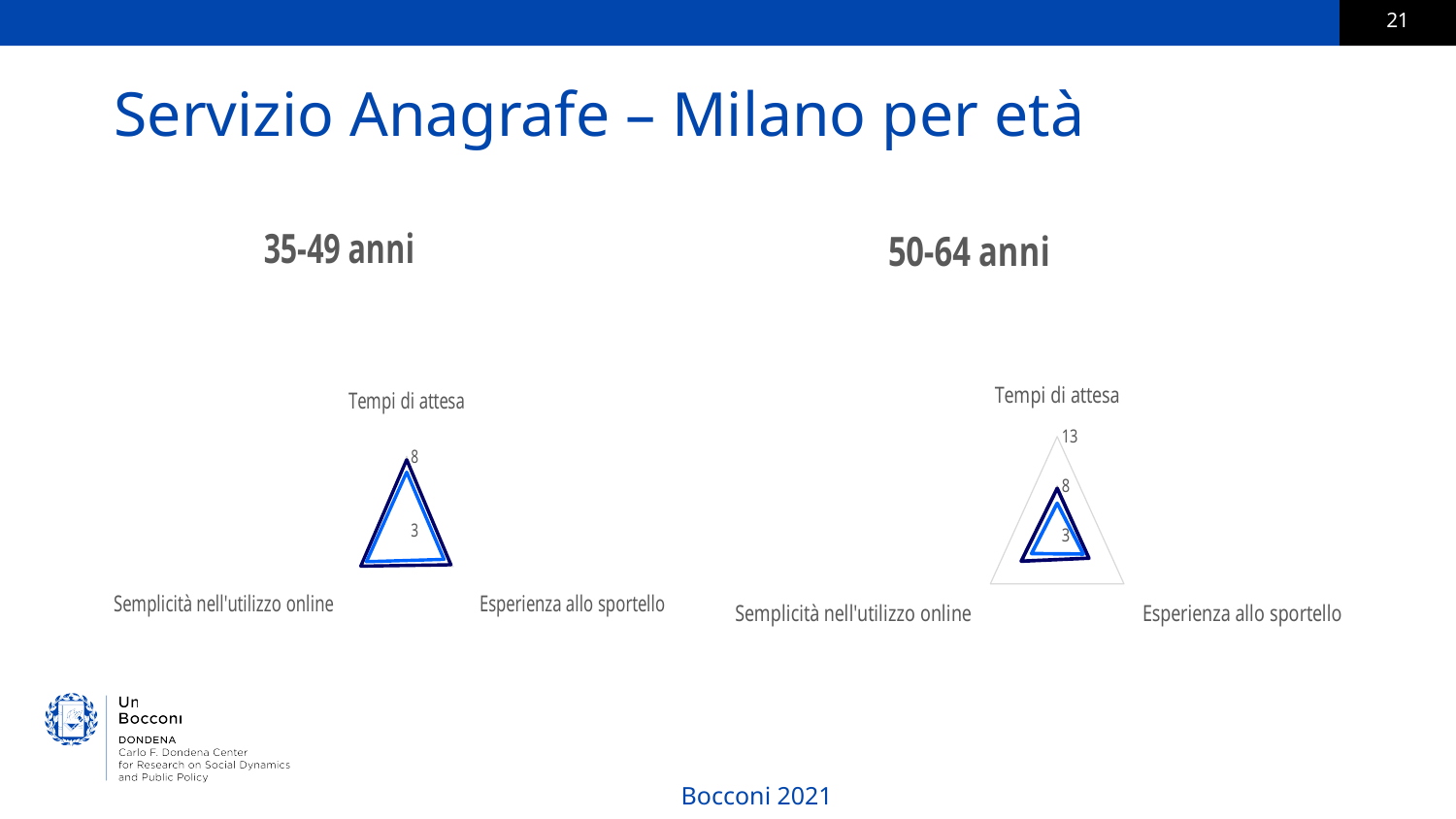
In the 50-64 anni chart, is the value for Esperienza allo sportello greater or less than 13? less In the 35-49 anni chart, is the value for Tempi di attesa greater or less than 3? greater How many axes (categories) does the 35-49 anni radar chart have? 3 In the 50-64 anni chart, is the value for Tempi di attesa greater or less than 13? less How many axes (categories) does the 50-64 anni radar chart have? 3 What kind of chart is used for the 50-64 anni group? radar chart What is the highest axis tick value shown on the 35-49 anni radar chart? 8 What kind of chart is used for the 35-49 anni group? radar chart What is the highest axis tick value shown on the 50-64 anni radar chart? 13